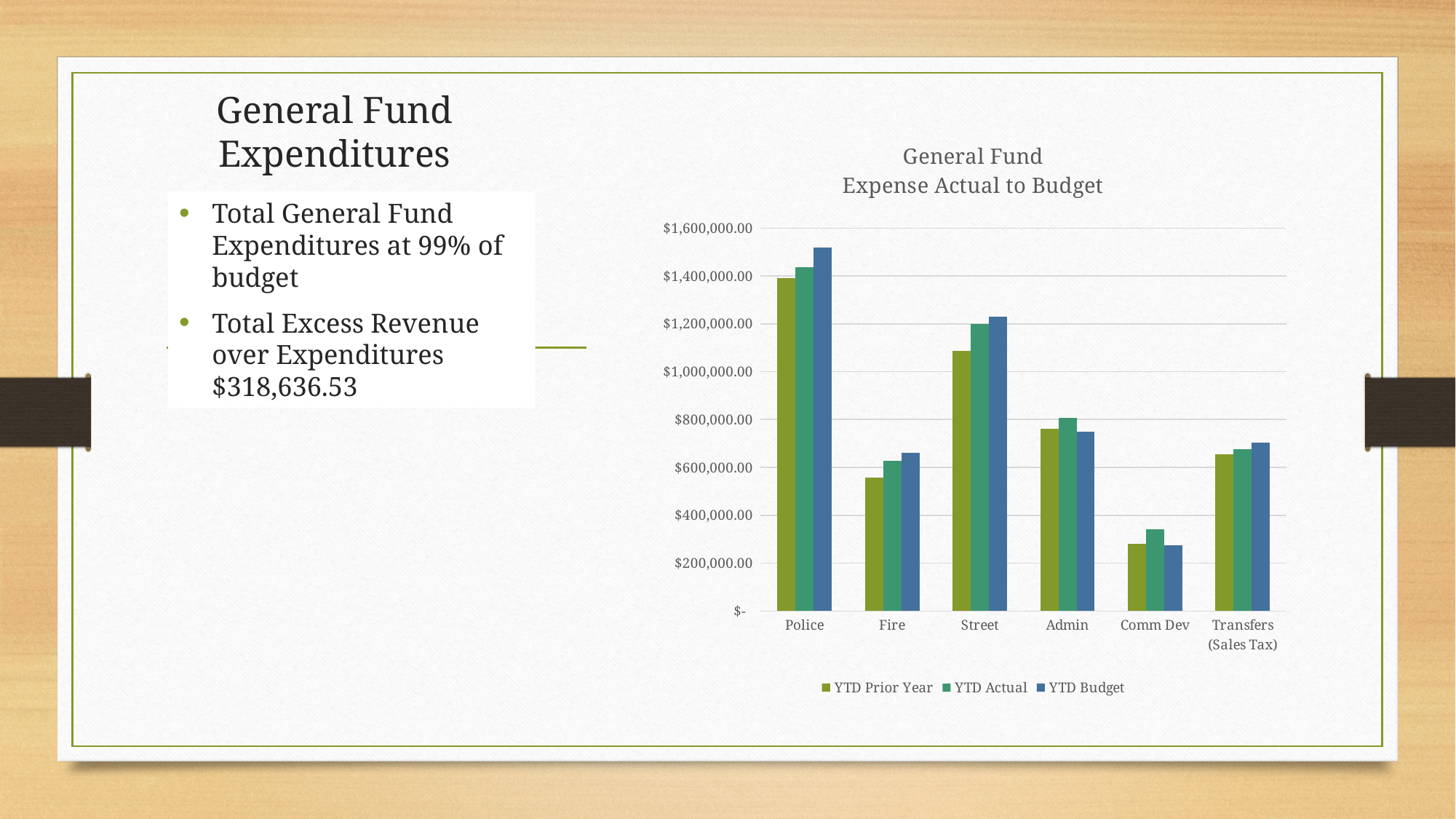
Is the YTD Budget value for Transfers (Sales Tax) greater or less than $600,000.00? greater What kind of chart is shown on the slide? bar chart How many categories are shown on the x axis of the chart? 6 Which category has the highest YTD Budget value? Police Is the YTD Prior Year value for Fire greater or less than $600,000.00? less For Admin, which is larger: the YTD Actual value or the YTD Budget value? YTD Actual For Comm Dev, which is larger: the YTD Actual value or the YTD Budget value? YTD Actual Is the YTD Prior Year value for Admin greater or less than $800,000.00? less How many series does the chart legend list? 3 What is the title of the chart? General Fund Expense Actual to Budget Which category has the lowest YTD Actual value? Comm Dev